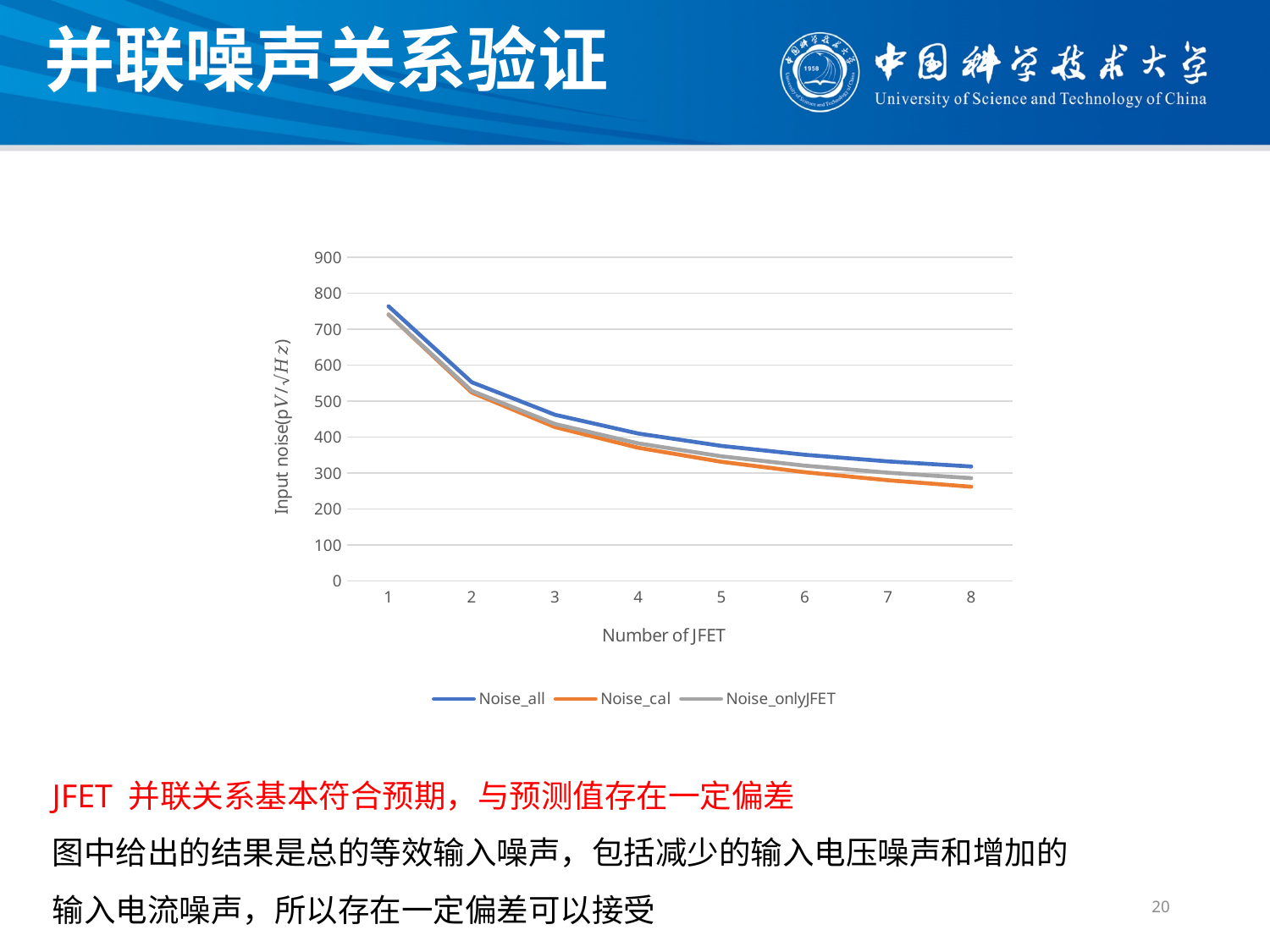
How many points along the x axis (Number of JFET) does each series have? 8 Is the Noise_all value at 2 JFET greater or less than 500? greater At which number of JFET is the Noise_all value highest? 1 Is the Noise_all value at 8 JFET greater or less than 400? less Is the Noise_all value at 1 JFET greater or less than 700? greater How many series does the chart's legend list? 3 At which number of JFET is the Noise_cal value lowest? 8 At 8 JFET, which is larger, Noise_all or Noise_cal? Noise_all Do the Noise_all values rise or fall as the number of JFET increases? fall What kind of chart is shown on the slide? line chart What is the title of the x axis of the chart? Number of JFET